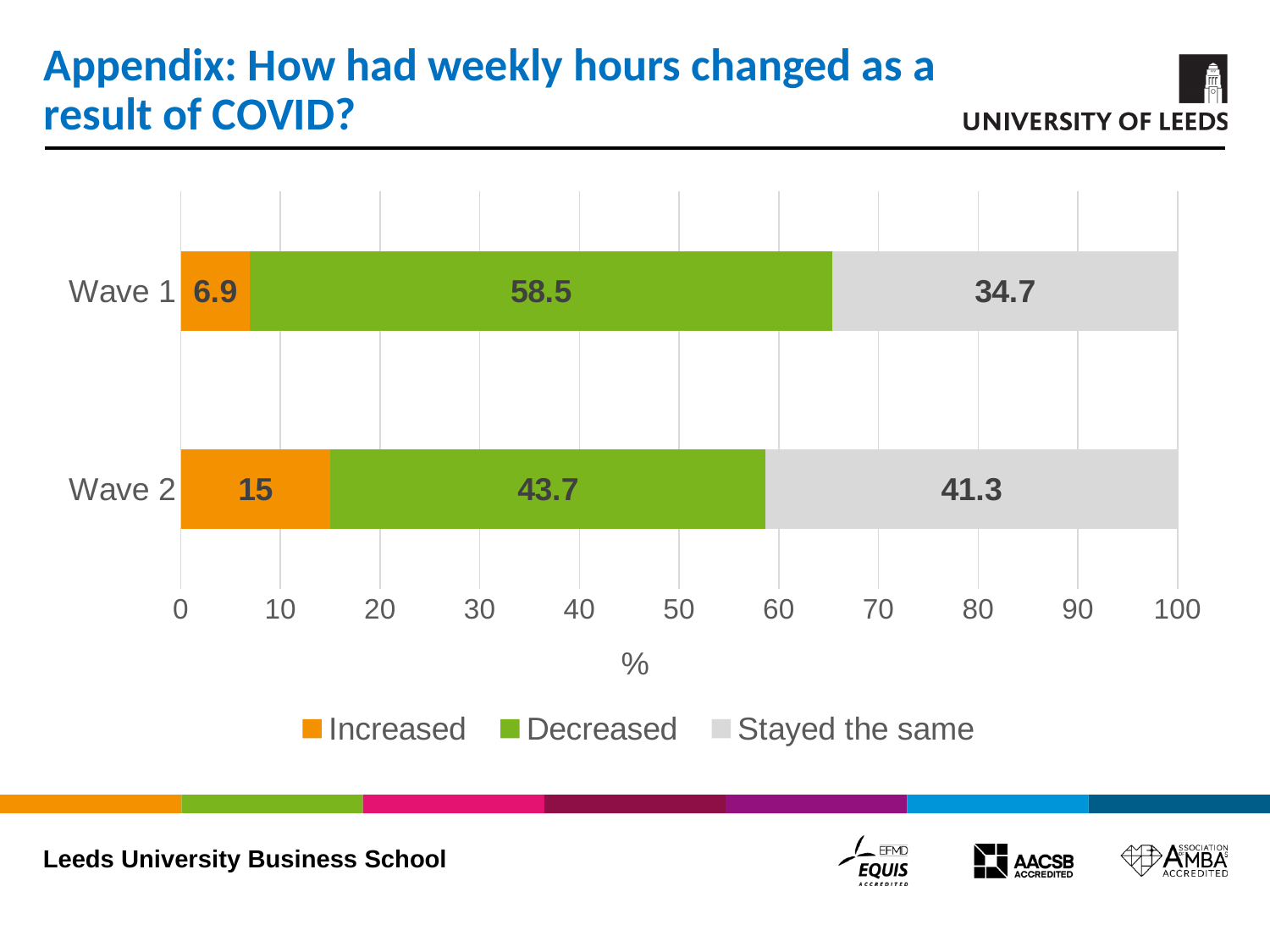
What is the value for 'Increased' in Wave 2? 15 What type of chart is shown on the slide? Stacked bar chart What is the value for 'Stayed the same' in Wave 2? 41.3 What is the value for 'Stayed the same' in Wave 1? 34.7 What percentage of respondents in Wave 1 said their weekly hours had decreased? 58.5 Which wave has the higher value for 'Decreased'? Wave 1 What is the total of the stacked bar for Wave 2? 100 Which wave has the lower value for 'Increased'? Wave 1 By how much did the 'Increased' value rise from Wave 1 to Wave 2? 8.1 What is the difference between the 'Decreased' values for Wave 1 and Wave 2? 14.8 How many categories (waves) are shown on the chart? 2 How many series does the legend list? 3